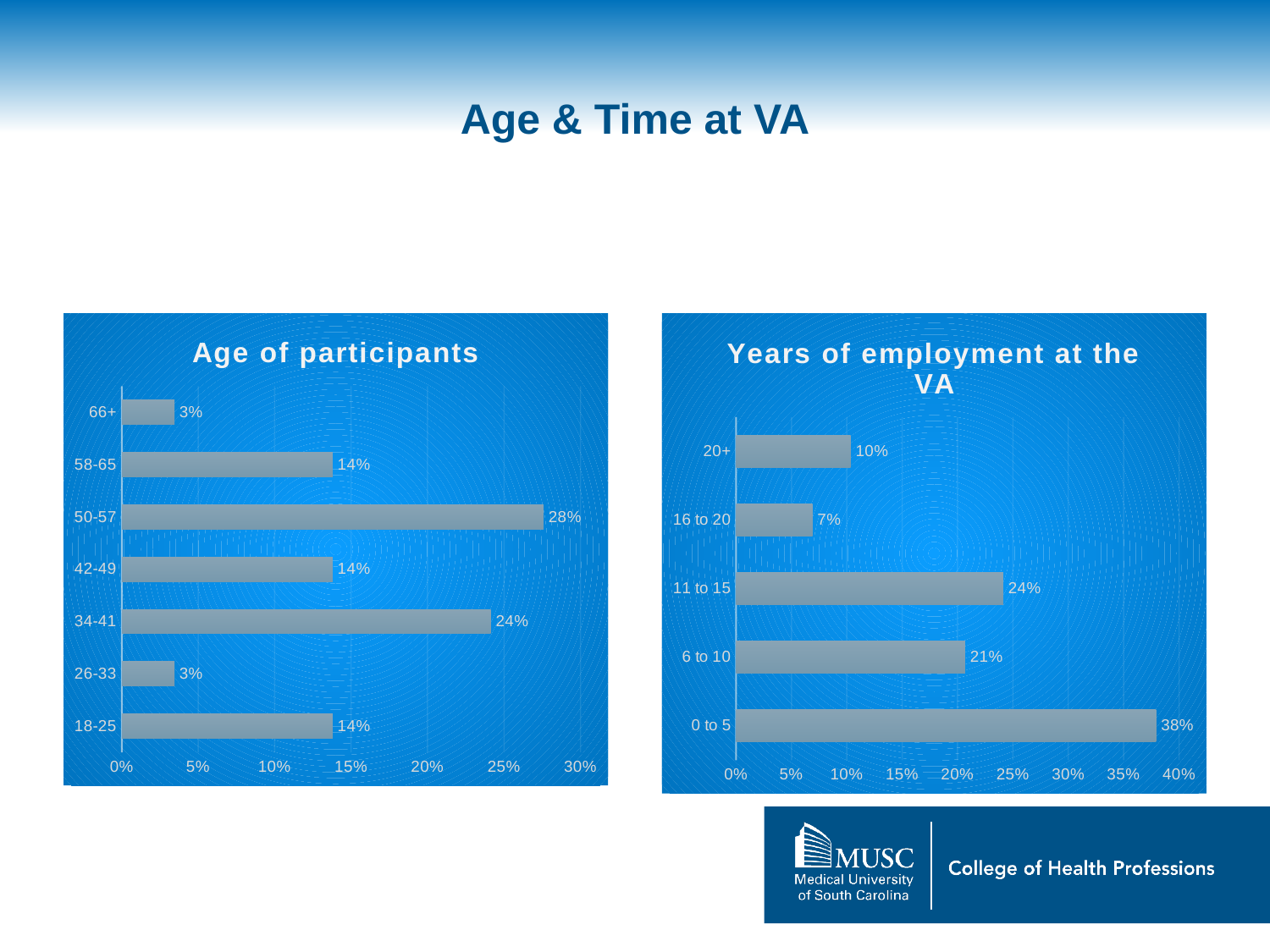
What type of chart is the 'Age of participants' chart? Bar chart In the 'Years of employment at the VA' chart, what is the value for 0 to 5 years? 38% In the 'Years of employment at the VA' chart, how many categories are shown? 5 In the 'Years of employment at the VA' chart, which is larger, 11 to 15 or 6 to 10? 11 to 15 In the 'Age of participants' chart, what is the value for the 50-57 age group? 28% In the 'Age of participants' chart, which age group has the highest value? 50-57 In the 'Years of employment at the VA' chart, which category has the lowest value? 16 to 20 In the 'Age of participants' chart, what is the difference between the 34-41 and 58-65 values? 10% In the 'Age of participants' chart, what is the value for the 66+ age group? 3% What is the title of the chart on the right side of the slide? Years of employment at the VA In the 'Years of employment at the VA' chart, what is the difference between the 0 to 5 and 20+ values? 28% In the 'Age of participants' chart, how many age groups are shown? 7